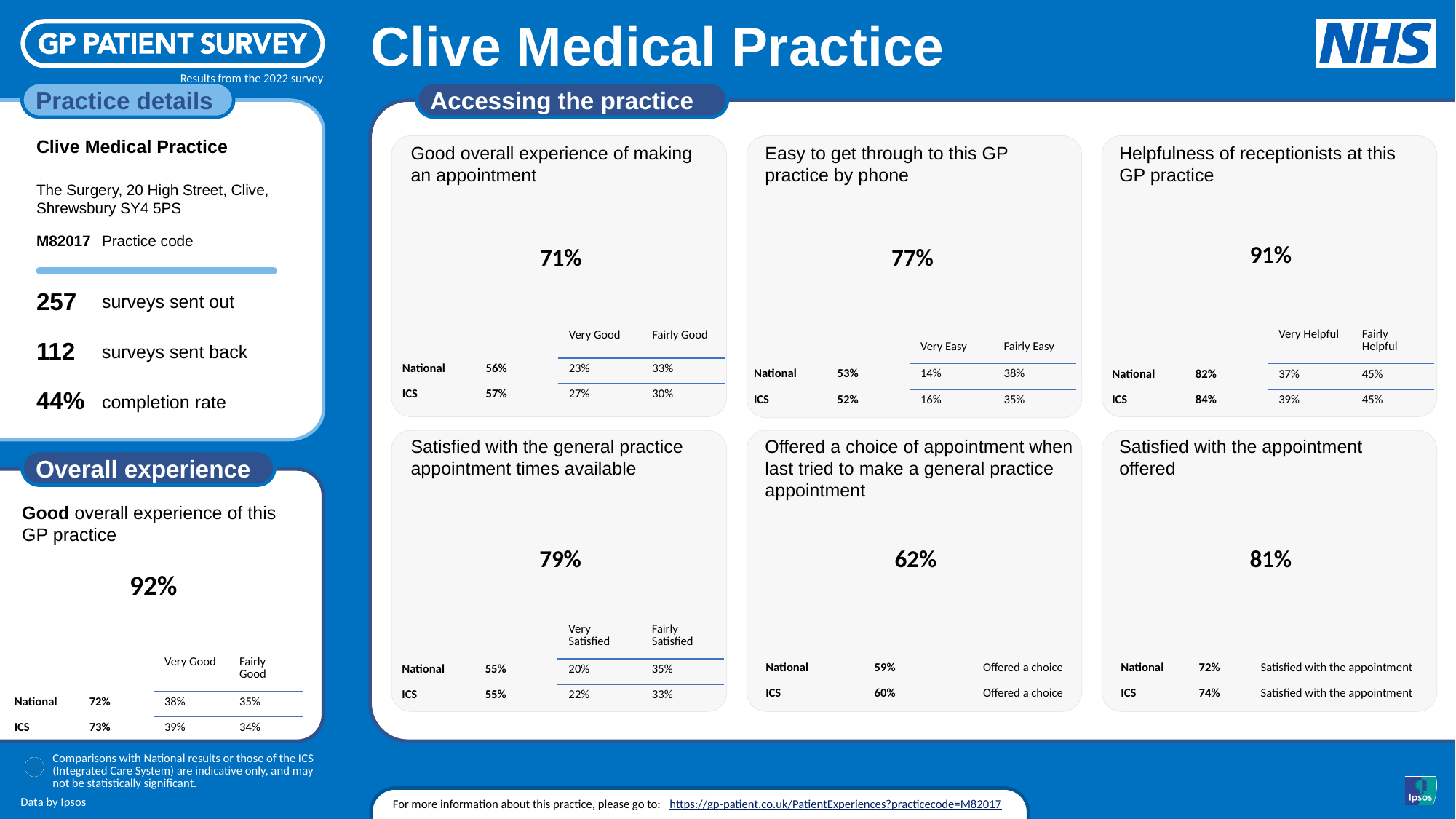
How many charts are shown in the 'Accessing the practice' section? 6 On the 'Satisfied with the appointment offered' chart, what is the practice's headline value? 81% On the 'Easy to get through to this GP practice by phone' chart, what is the practice's headline value? 77% On the 'Offered a choice of appointment when last tried to make a general practice appointment' chart, what is the practice's headline value? 62% On the 'Easy to get through to this GP practice by phone' chart, which is larger: the National value or the ICS value? National On the 'Helpfulness of receptionists at this GP practice' chart, what is the practice's headline value? 91% On the 'Satisfied with the general practice appointment times available' chart, what is the practice's headline value? 79% Among the six charts in the 'Accessing the practice' section, which has the lowest headline value? Offered a choice of appointment when last tried to make a general practice appointment Among the six charts in the 'Accessing the practice' section, which has the highest headline value? Helpfulness of receptionists at this GP practice What is the difference between the practice's headline value on the 'Helpfulness of receptionists at this GP practice' chart and the National value shown beneath it? 9% On the 'Good overall experience of this GP practice' chart in the Overall experience section, what is the practice's headline value? 92% On the 'Good overall experience of making an appointment' chart, what is the practice's headline value? 71%